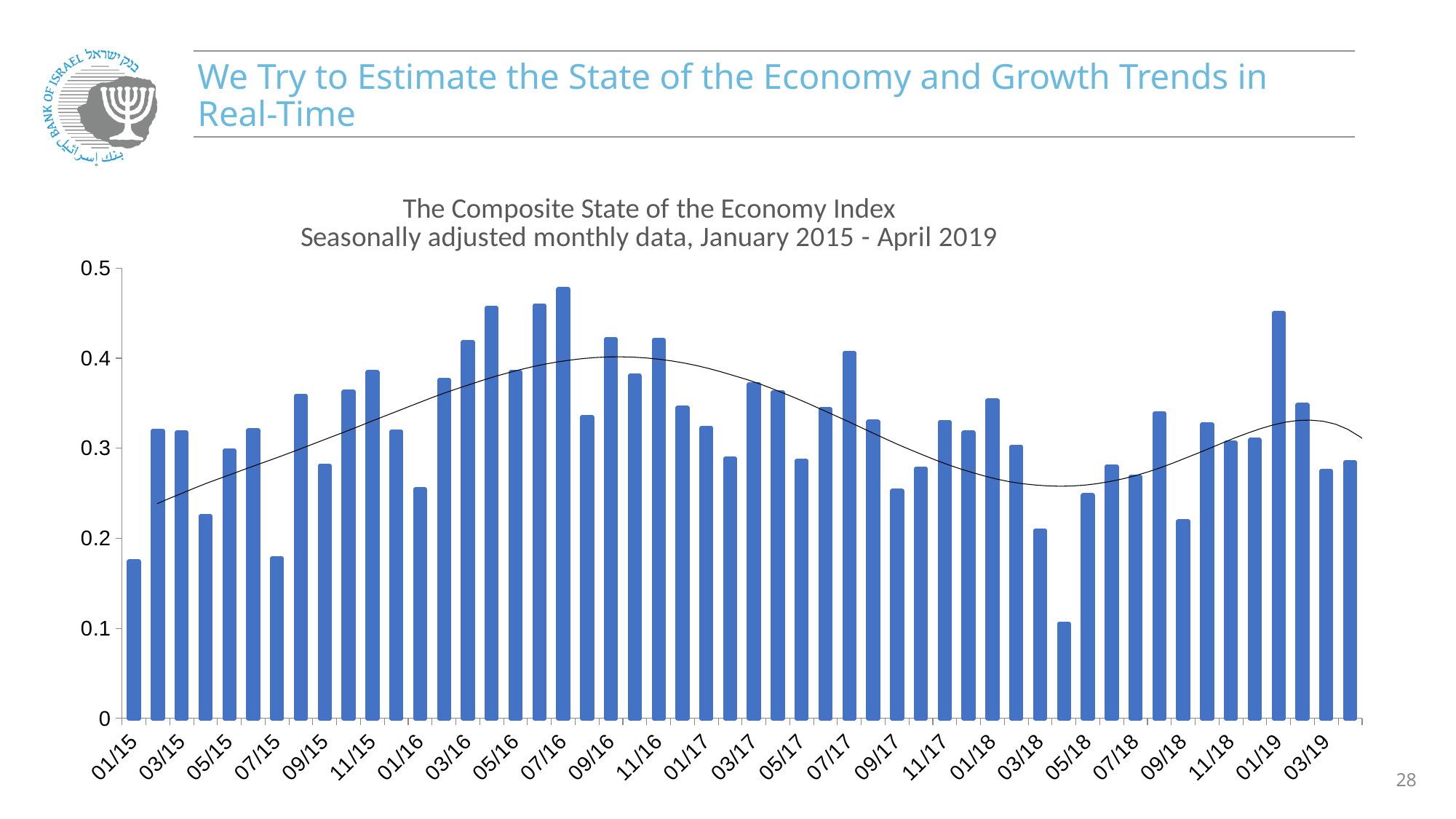
Which labeled month has the highest bar? 07/16 Is the value for 09/15 greater or less than 0.3? less Which has the larger value, 05/16 or 05/18? 05/16 Which has the larger value, 01/19 or 03/19? 01/19 What kind of chart is shown on the slide? Bar chart What is the title of the chart? The Composite State of the Economy Index What period does the chart's subtitle say the data covers? January 2015 - April 2019 Is the value for 03/16 greater or less than 0.4? greater Is the value for 07/16 greater or less than 0.4? greater Do the values generally rise or fall from 01/15 to 07/16? Rise